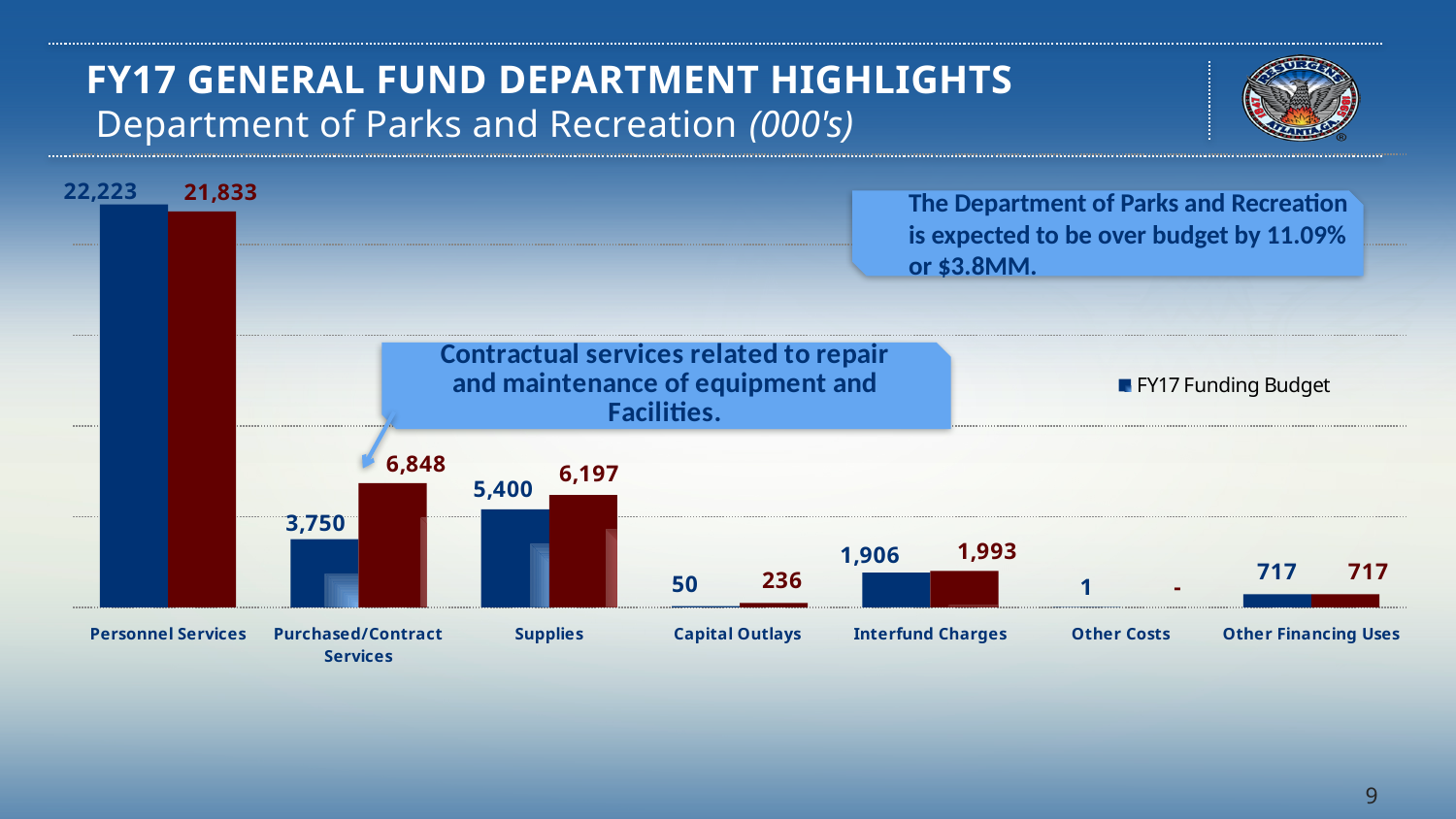
For Personnel Services, how much larger is the FY17 Funding Budget (22,223) than the dark red bar value (21,833)? 390 For Purchased/Contract Services, what is the difference between the dark red bar (6,848) and the FY17 Funding Budget (3,750)? 3,098 What is the FY17 Funding Budget value for Supplies? 5,400 For Supplies, which is larger: the FY17 Funding Budget bar or the dark red bar? the dark red bar Which category has the highest FY17 Funding Budget value? Personnel Services What is the value of the dark red bar for Purchased/Contract Services? 6,848 What is the FY17 Funding Budget value for Other Financing Uses? 717 Which category has the lowest FY17 Funding Budget value? Other Costs How many categories are shown on the x axis of the chart? 7 What is the FY17 Funding Budget value for Personnel Services? 22,223 What type of chart is shown on the slide? bar chart What is the FY17 Funding Budget value for Capital Outlays? 50